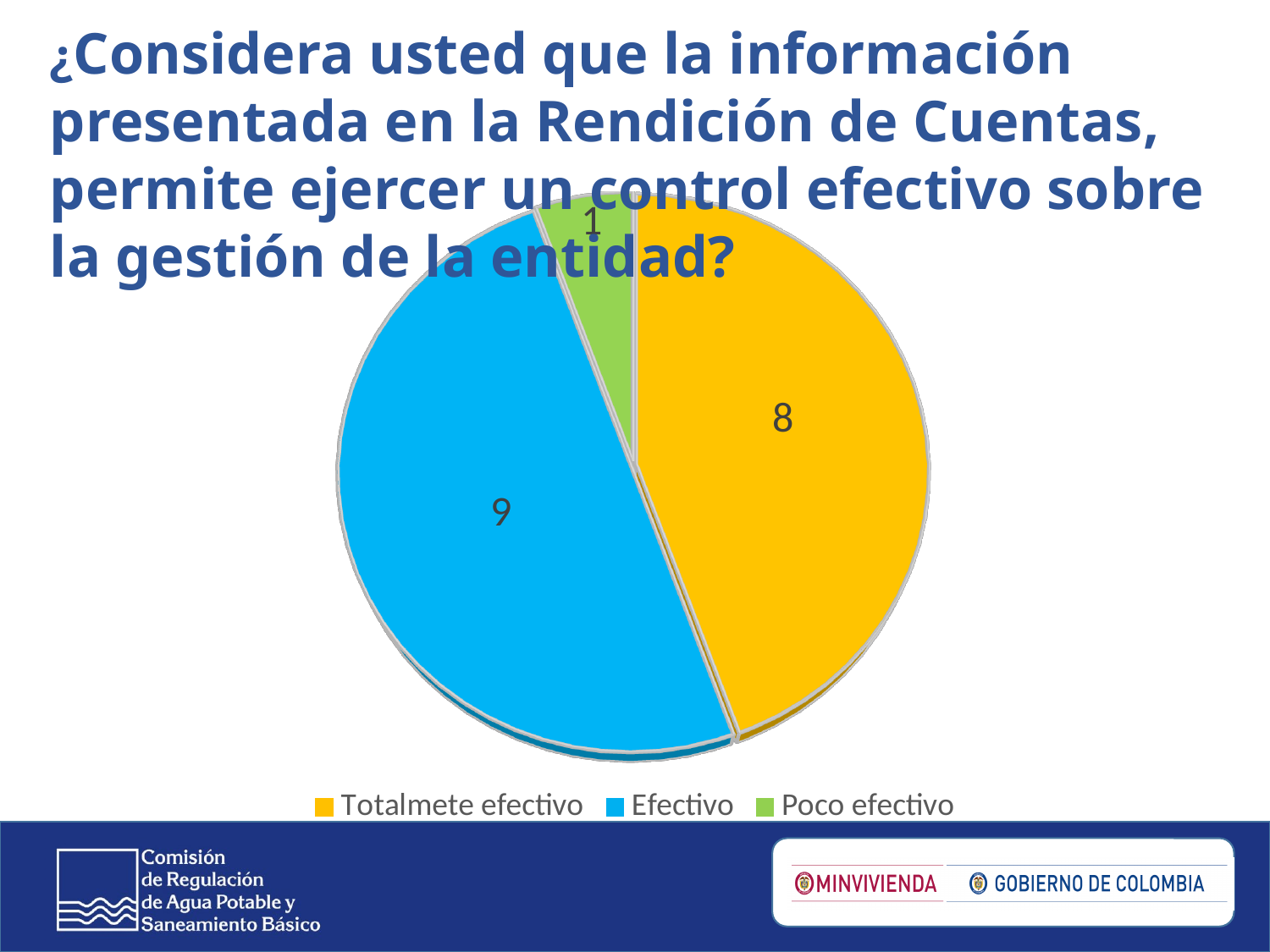
What kind of chart is shown on the slide? pie chart What is the value for the "Poco efectivo" slice? 1 Which category has the largest slice of the pie? Efectivo How many categories does the pie chart have? 3 What is the difference between the values for "Totalmete efectivo" and "Poco efectivo"? 7 What colour is the "Poco efectivo" slice in the pie chart? green Which is larger, the value for "Efectivo" or the value for "Poco efectivo"? Efectivo What is the value for the "Efectivo" slice? 9 What share of the pie does the "Efectivo" slice represent? 50% What is the value for the "Totalmete efectivo" slice? 8 What is the difference between the values for "Efectivo" and "Totalmete efectivo"? 1 Which category has the smallest slice of the pie? Poco efectivo